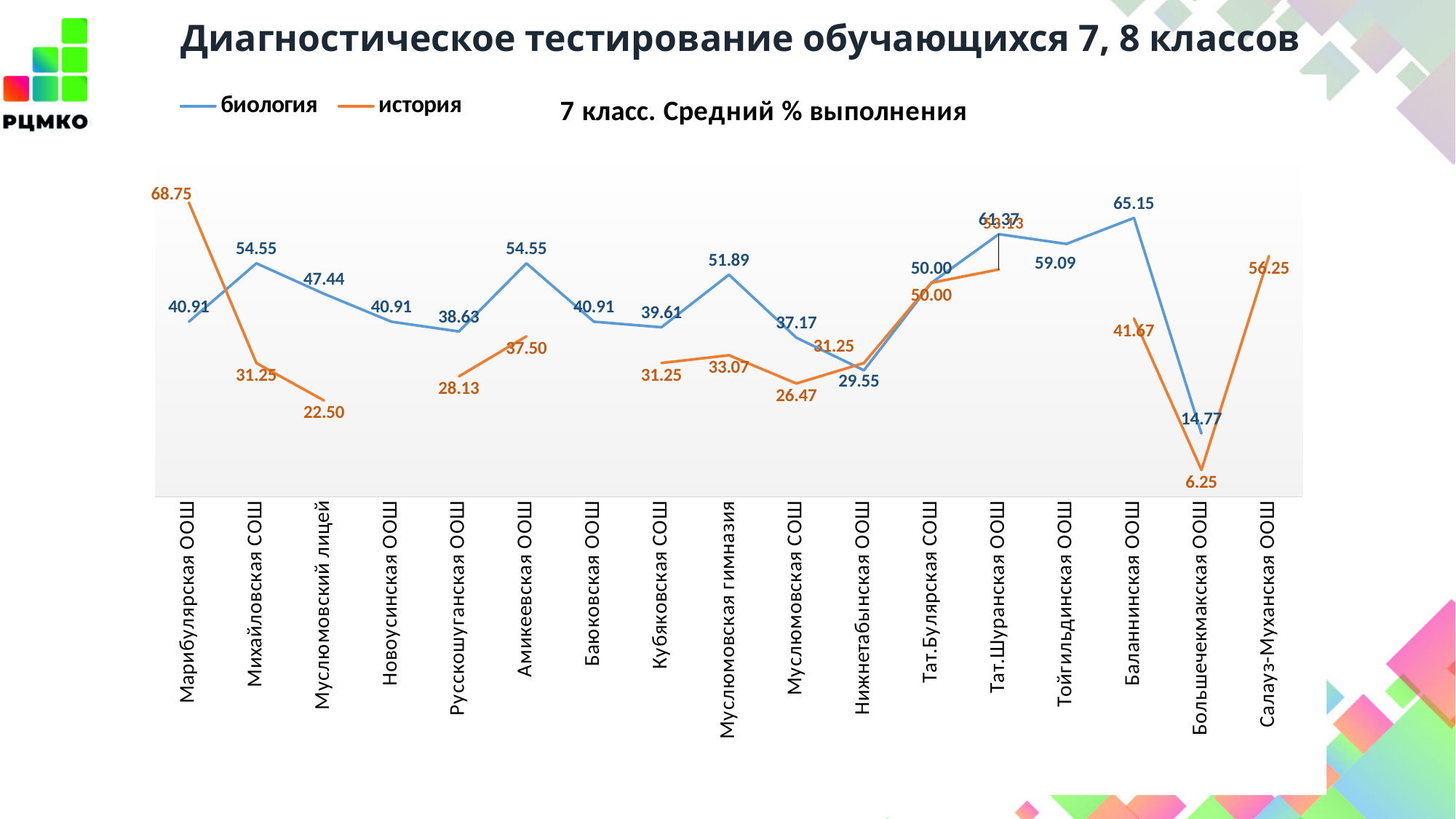
What is the difference between the биология and история values for Большечекмакская ООШ? 8.52 What is the история value for Марибулярская ООШ? 68.75 What kind of chart is shown on the slide? line chart What is the title of the chart? 7 класс. Средний % выполнения Which school has the highest биология value? Баланнинская ООШ How many schools are shown along the x axis? 17 How many series does the legend list? 2 What is the история value for Муслюмовский лицей? 22.50 Which is larger for Амикеевская ООШ, the биология value or the история value? биология Which school has the lowest история value? Большечекмакская ООШ What is the биология value for Баланнинская ООШ? 65.15